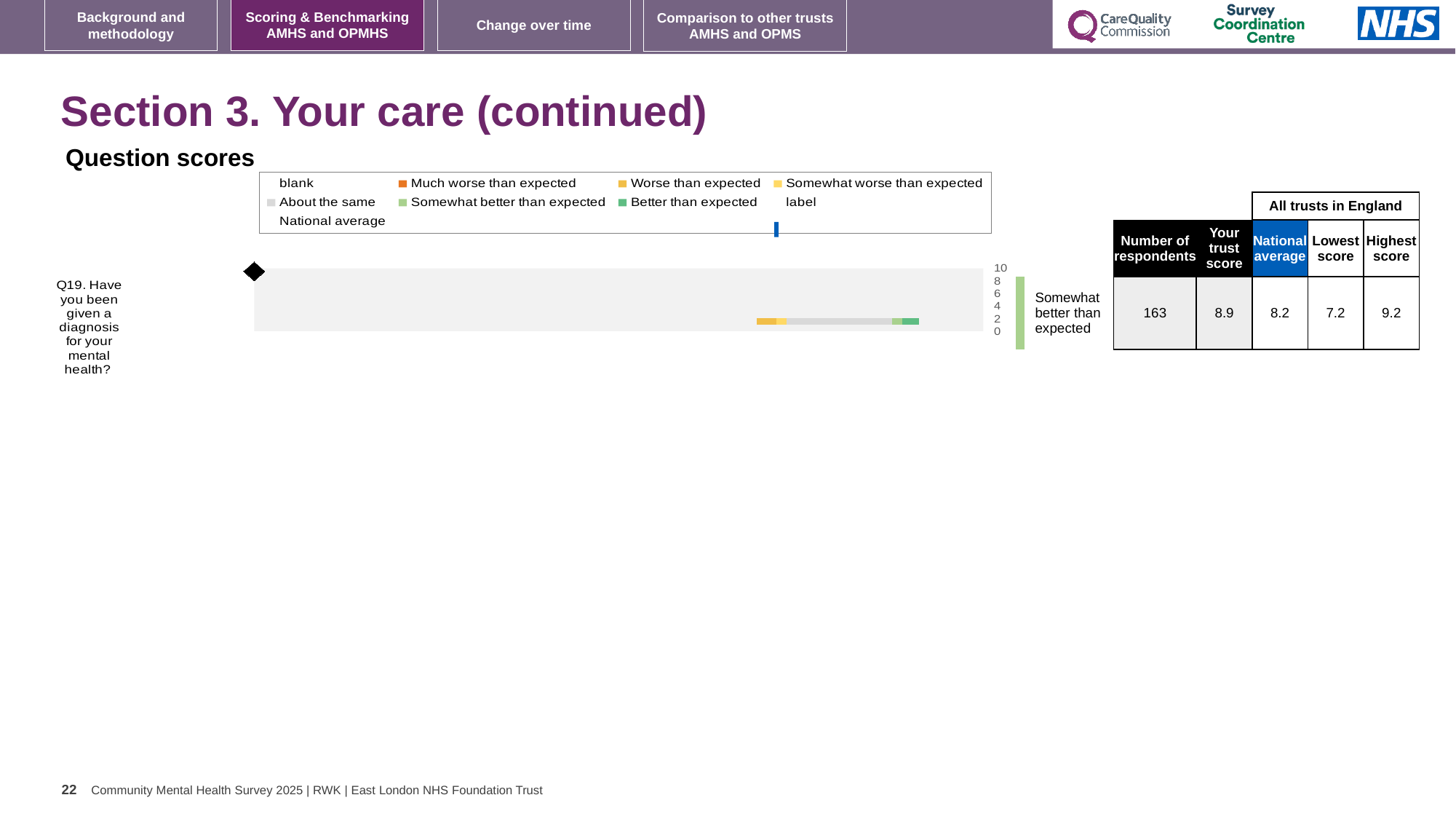
What kind of chart is used to show the Q19 question score? bar chart What is the difference between the highest and lowest scores among all trusts in England for Q19? 2.0 What is the trust's score for Q19 according to the table beside the chart? 8.9 What is the lowest score among all trusts in England for Q19? 7.2 What is the highest tick value shown on the score axis of the chart? 10 By how much does the trust's Q19 score exceed the national average? 0.7 What is the highest score among all trusts in England for Q19? 9.2 Which survey question is plotted in the Question scores chart? Q19. Have you been given a diagnosis for your mental health? What is the national average score for Q19? 8.2 Which is larger for Q19, the trust's score or the national average? the trust's score How many survey questions are plotted in the Question scores chart? 1 How many respondents answered Q19? 163